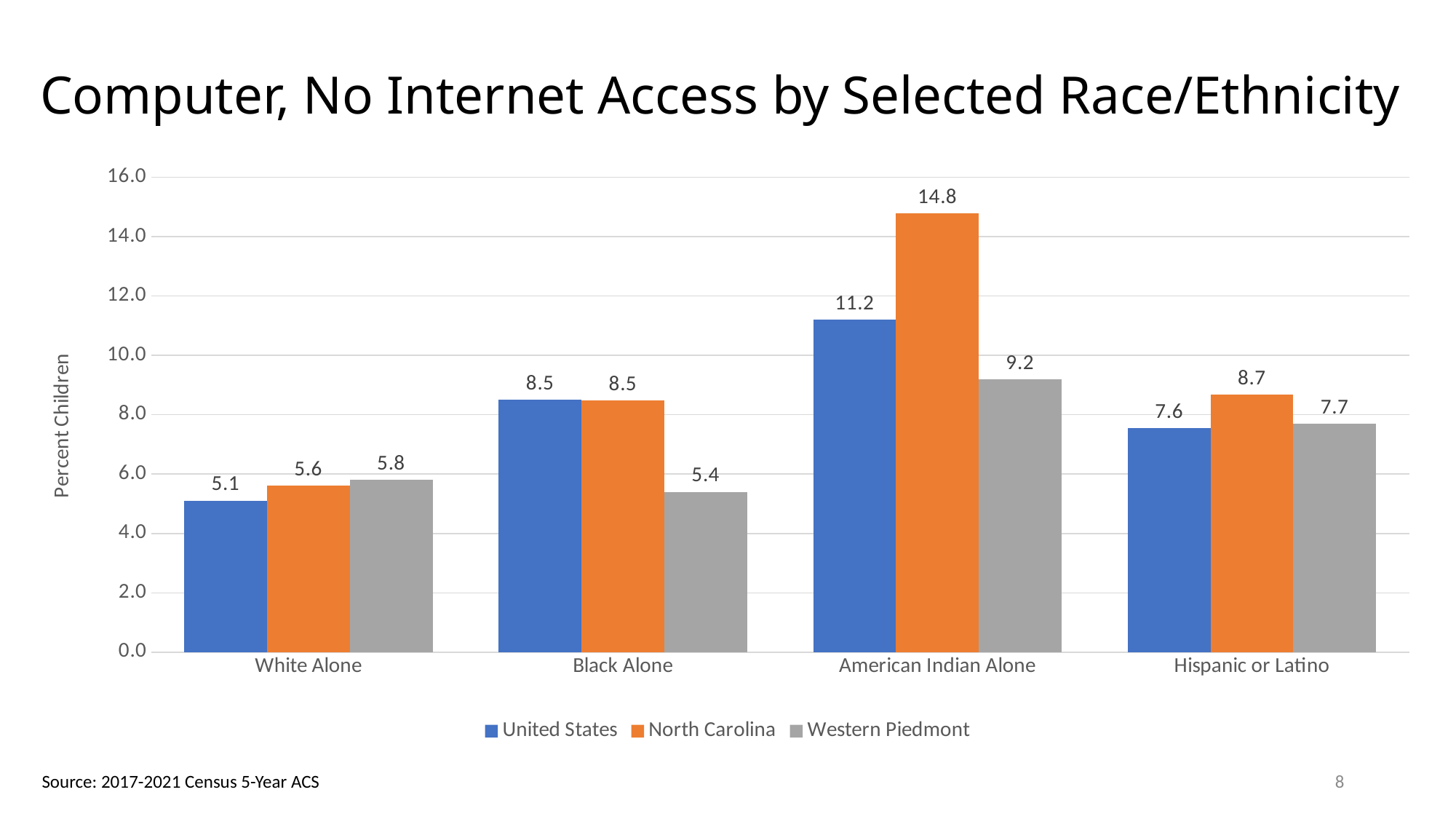
Is the value for North Carolina in the American Indian Alone category greater or less than 14.0? greater What is the value for Western Piedmont in the Black Alone category? 5.4 How many race/ethnicity categories are shown on the x axis? 4 Which is larger in the White Alone category: the United States value or the Western Piedmont value? Western Piedmont What kind of chart is shown on the slide? Bar chart How many series does the legend list? 3 What is the label of the y axis? Percent Children What is the difference between the North Carolina and United States values in the American Indian Alone category? 3.6 What is the value for United States in the Hispanic or Latino category? 7.6 What is the value for North Carolina in the American Indian Alone category? 14.8 Which category has the lowest value for the North Carolina series? White Alone Which category has the highest value for the United States series? American Indian Alone